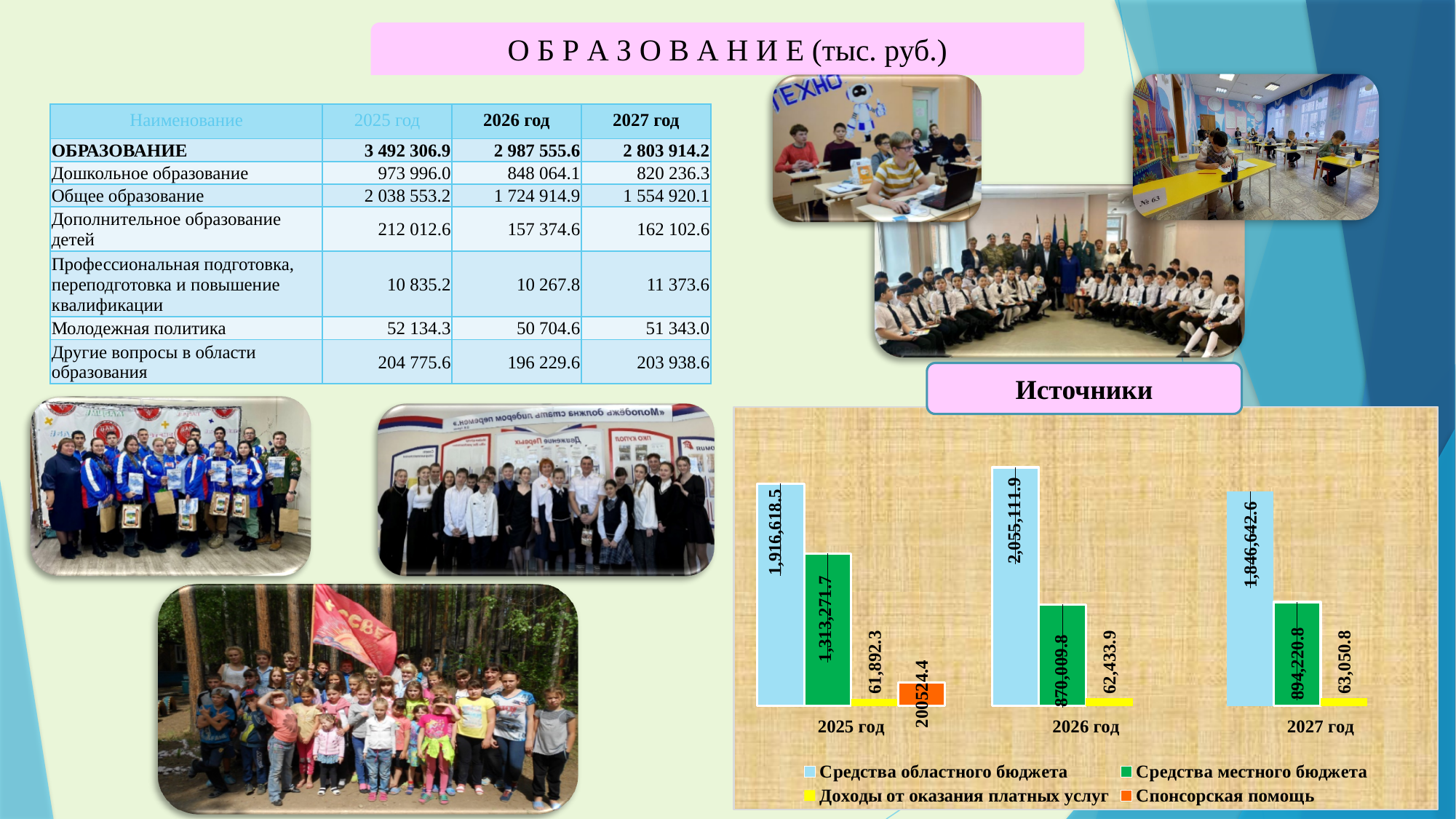
What kind of chart is shown under the heading «Источники»? bar chart In the «Источники» chart, what is the value of «Спонсорская помощь» for 2025 год? 200524.4 In the «Источники» chart, what is the value of «Средства местного бюджета» for 2025 год? 1,313,271.7 How many series does the legend of the «Источники» chart list? 4 In the «Источники» chart, which year has the lowest value for «Средства местного бюджета»? 2026 год In the «Источники» chart, what is the value of «Доходы от оказания платных услуг» for 2027 год? 63,050.8 How many year categories are shown on the x axis of the «Источники» chart? 3 In the «Источники» chart, what is the value of «Средства областного бюджета» for 2026 год? 2,055,111.9 In the «Источники» chart, which year has the highest value for «Средства областного бюджета»? 2026 год In the «Источники» chart, do the values for «Доходы от оказания платных услуг» rise or fall from 2025 год to 2027 год? rise In the «Источники» chart, what is the difference between «Средства областного бюджета» in 2026 год and in 2025 год? 138,493.4 In the «Источники» chart, which is larger: «Средства местного бюджета» in 2025 год or in 2027 год? 2025 год